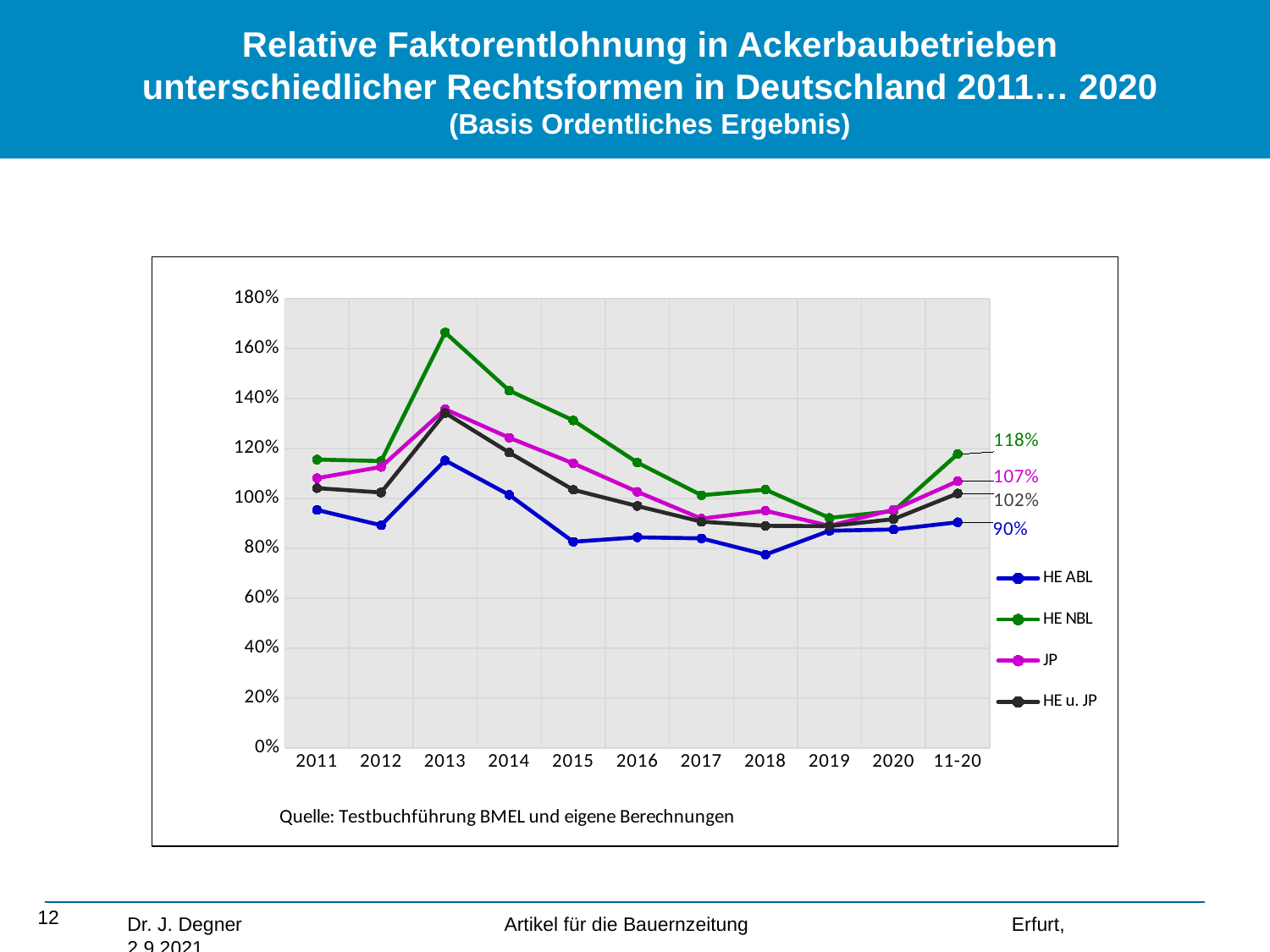
What is the value for HE u. JP at 11-20? 102% Which series is listed last in the legend? HE u. JP How many series does the legend list? 4 Which series has the highest value at 11-20? HE NBL What is the value for JP at 11-20? 107% Is the value for HE NBL in 2013 greater or less than 160%? greater In which year does the HE NBL series reach its highest value? 2013 What is the difference between the HE NBL and HE ABL values at 11-20? 28 percentage points What kind of chart is shown on the slide? line chart What is the value for HE ABL at 11-20? 90% How many categories are shown along the x axis? 11 What is the value for HE NBL at 11-20? 118%